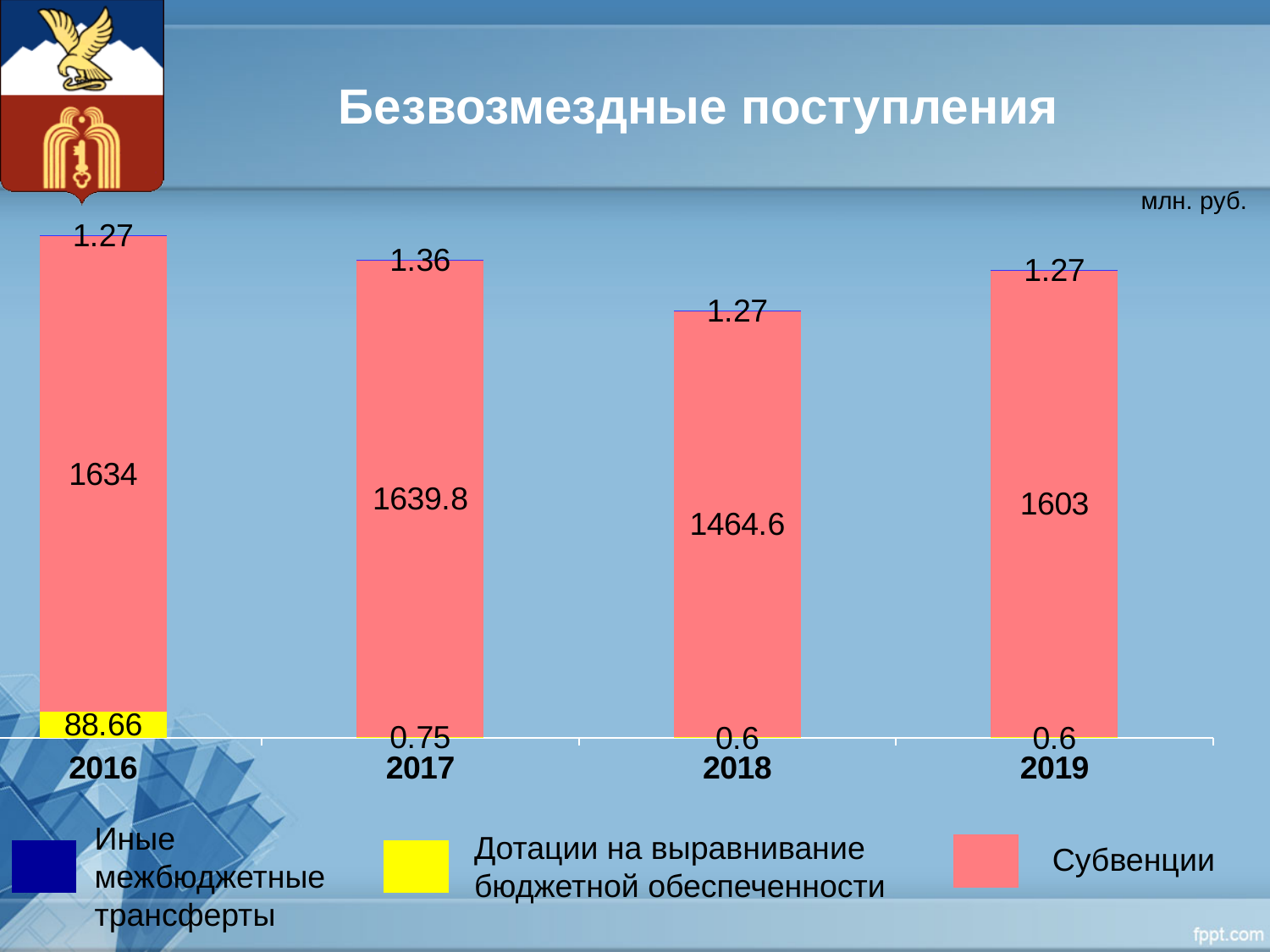
What is the value of Субвенции for 2018? 1464.6 How many years are shown on the x axis? 4 In which year is the value of Субвенции the lowest? 2018 In which year is the value of Субвенции the highest? 2017 What is the value of Дотации на выравнивание бюджетной обеспеченности for 2016? 88.66 What is the total of the stacked bar for 2019? 1604.87 How many series does the legend list? 3 What is the difference between the Субвенции values for 2017 and 2018? 175.2 What is the value of Субвенции for 2017? 1639.8 Which is larger: the Субвенции value for 2016 or for 2019? 2016 What is the value of Иные межбюджетные трансферты for 2017? 1.36 What kind of chart is shown on the slide? Stacked bar chart